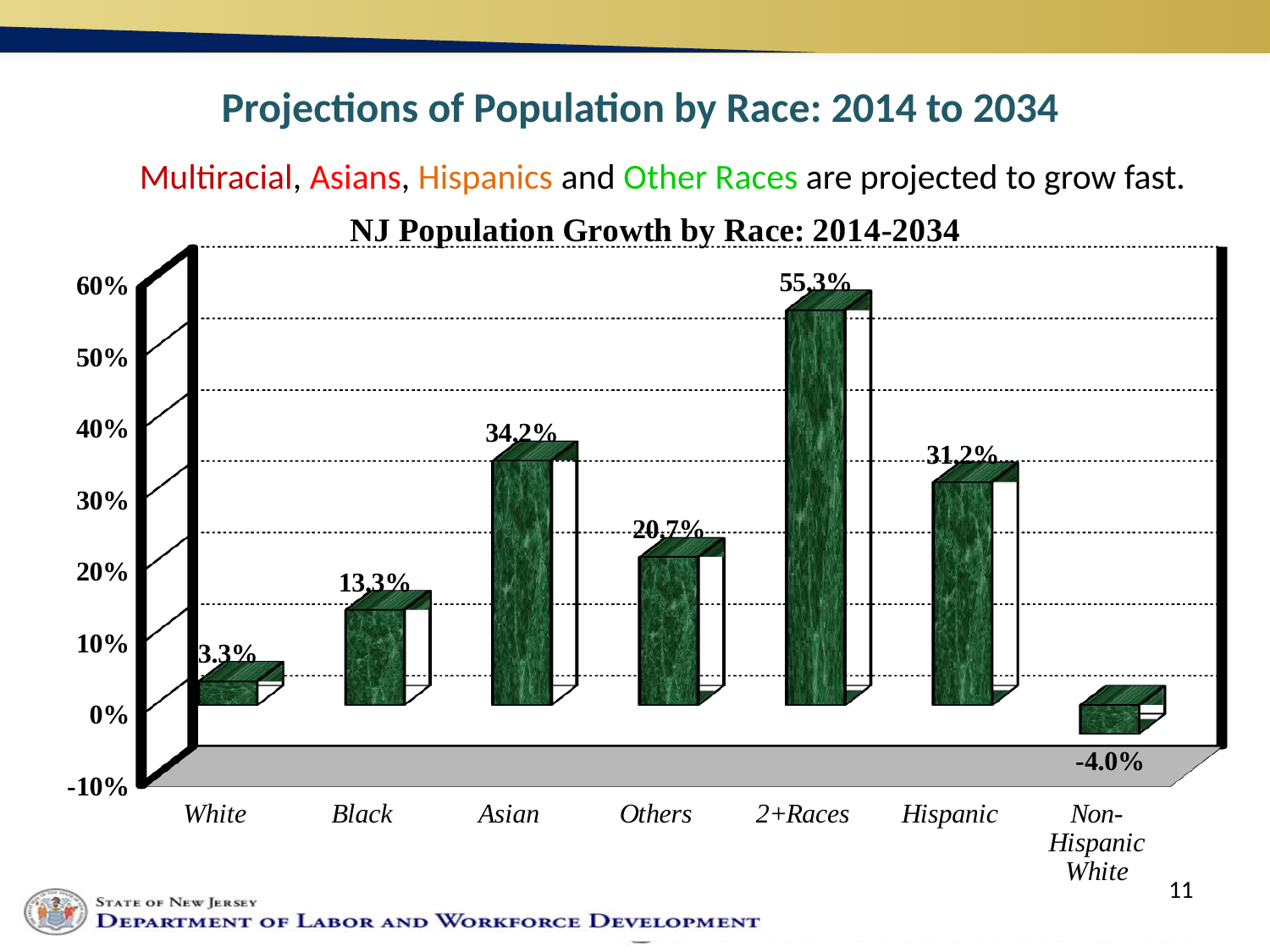
Which race category has the highest projected growth? 2+Races What is the projected population growth for Non-Hispanic White? -4.0% Which race category has the lowest projected growth? Non-Hispanic White What is the projected population growth for Asian? 34.2% What is the title of the chart? NJ Population Growth by Race: 2014-2034 How many race categories are shown in the chart? 7 What is the difference between the projected growth for 2+Races and Hispanic? 24.1% What is the difference between the projected growth for Black and White? 10.0% Is the projected growth for Asian greater or less than 30%? greater What kind of chart is shown on the slide? bar chart What is the projected population growth for Hispanic? 31.2% Which has a larger projected growth, Others or Black? Others